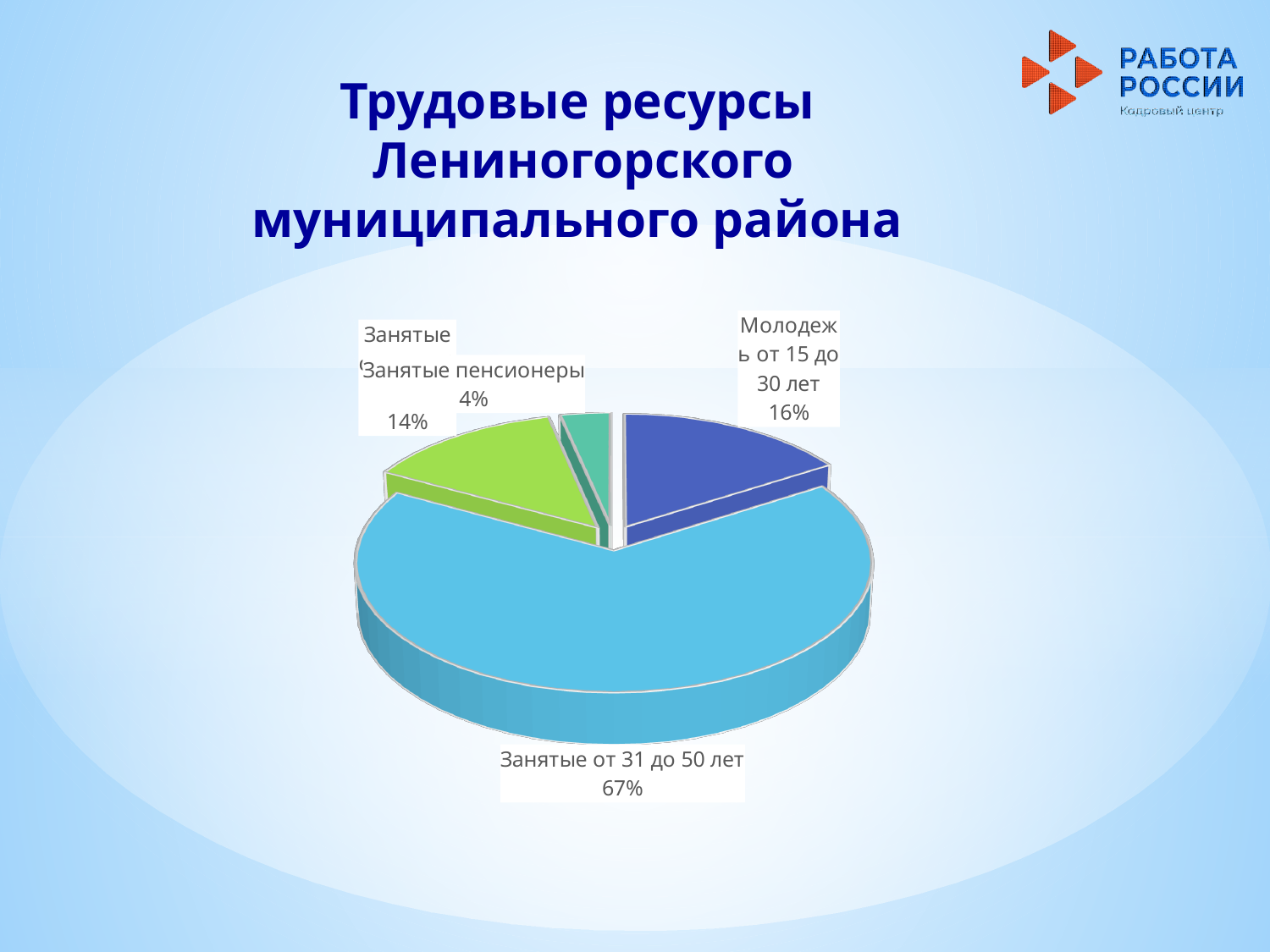
What is the title of the slide containing the pie chart? Трудовые ресурсы Лениногорского муниципального района What is the difference in percentage points between "Молодежь от 15 до 30 лет" and "Занятые пенсионеры"? 12 Which is larger: the share for "Молодежь от 15 до 30 лет" or the share for "Занятые пенсионеры"? Молодежь от 15 до 30 лет What share of the pie is labelled "Занятые от 31 до 50 лет"? 67% What colour is the slice for "Занятые от 31 до 50 лет"? light blue Which category has the largest slice of the pie? Занятые от 31 до 50 лет What is the difference in percentage points between "Занятые от 31 до 50 лет" and "Молодежь от 15 до 30 лет"? 51 What kind of chart is shown on the slide? pie chart What share of the pie is labelled "Занятые пенсионеры"? 4% What share of the pie is labelled "Молодежь от 15 до 30 лет"? 16% Which category has the smallest slice of the pie? Занятые пенсионеры How many slices does the pie chart have? 4